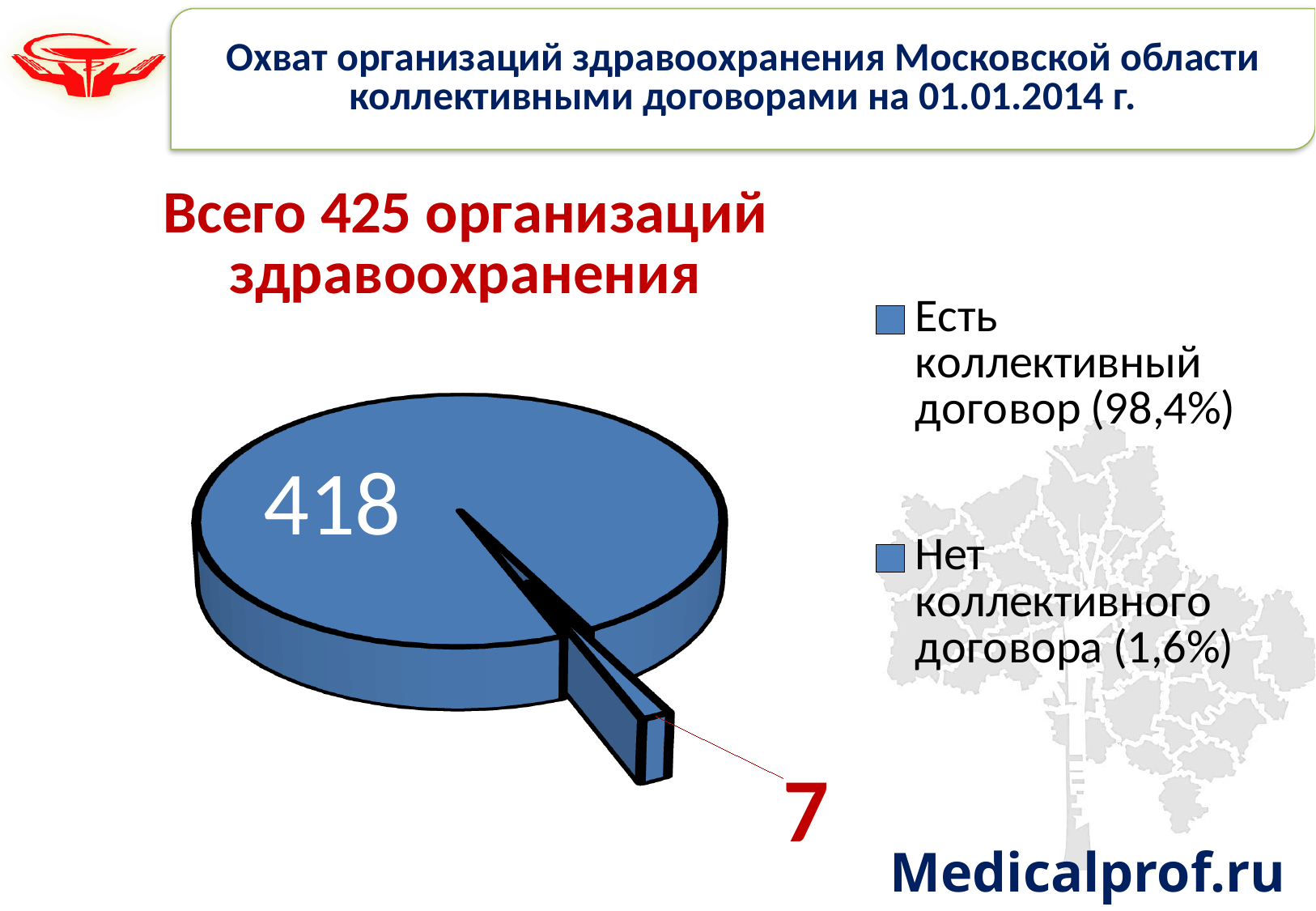
Which slice is the smallest? Нет коллективного договора What share of the pie does the slice for organisations without a collective agreement represent, as shown in the legend? 1,6% What is the difference between the number of organisations with a collective agreement and those without? 411 What share of the pie does the slice for organisations with a collective agreement represent, as shown in the legend? 98,4% What is the value of the slice for organisations that have a collective agreement (Есть коллективный договор)? 418 What is the value of the slice for organisations without a collective agreement (Нет коллективного договора)? 7 How many slices does the pie chart have? 2 What kind of chart is shown on the slide? pie chart How many entries does the legend list? 2 Which is larger: the slice for organisations with a collective agreement or the slice for those without? Есть коллективный договор What is the total number of healthcare organisations stated above the chart? 425 Which slice is the largest? Есть коллективный договор